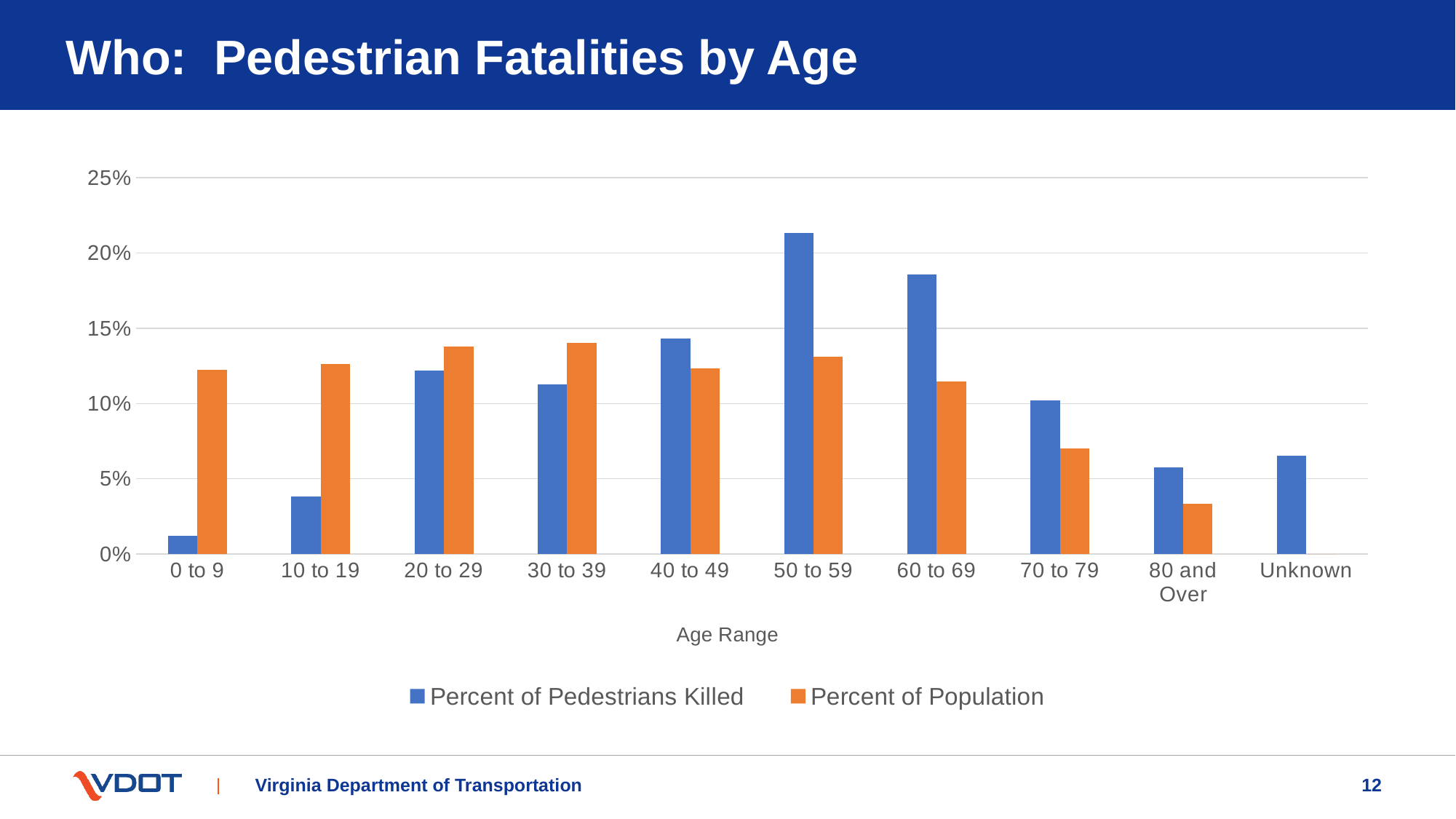
Is the Percent of Population for 0 to 9 greater or less than 10%? greater Which age range has the highest Percent of Pedestrians Killed? 50 to 59 Is the Percent of Pedestrians Killed for 50 to 59 greater or less than 20%? greater What kind of chart is shown on the slide? Bar chart For the 0 to 9 age range, which is larger: Percent of Pedestrians Killed or Percent of Population? Percent of Population How many series does the legend list? 2 What is the title of the x axis? Age Range How many age range categories are shown on the x axis? 10 For the 60 to 69 age range, which is larger: Percent of Pedestrians Killed or Percent of Population? Percent of Pedestrians Killed Is the Percent of Pedestrians Killed for 10 to 19 greater or less than 5%? less Among the age ranges with a Percent of Population bar, which has the lowest Percent of Population? 80 and Over Which age range has the lowest Percent of Pedestrians Killed? 0 to 9